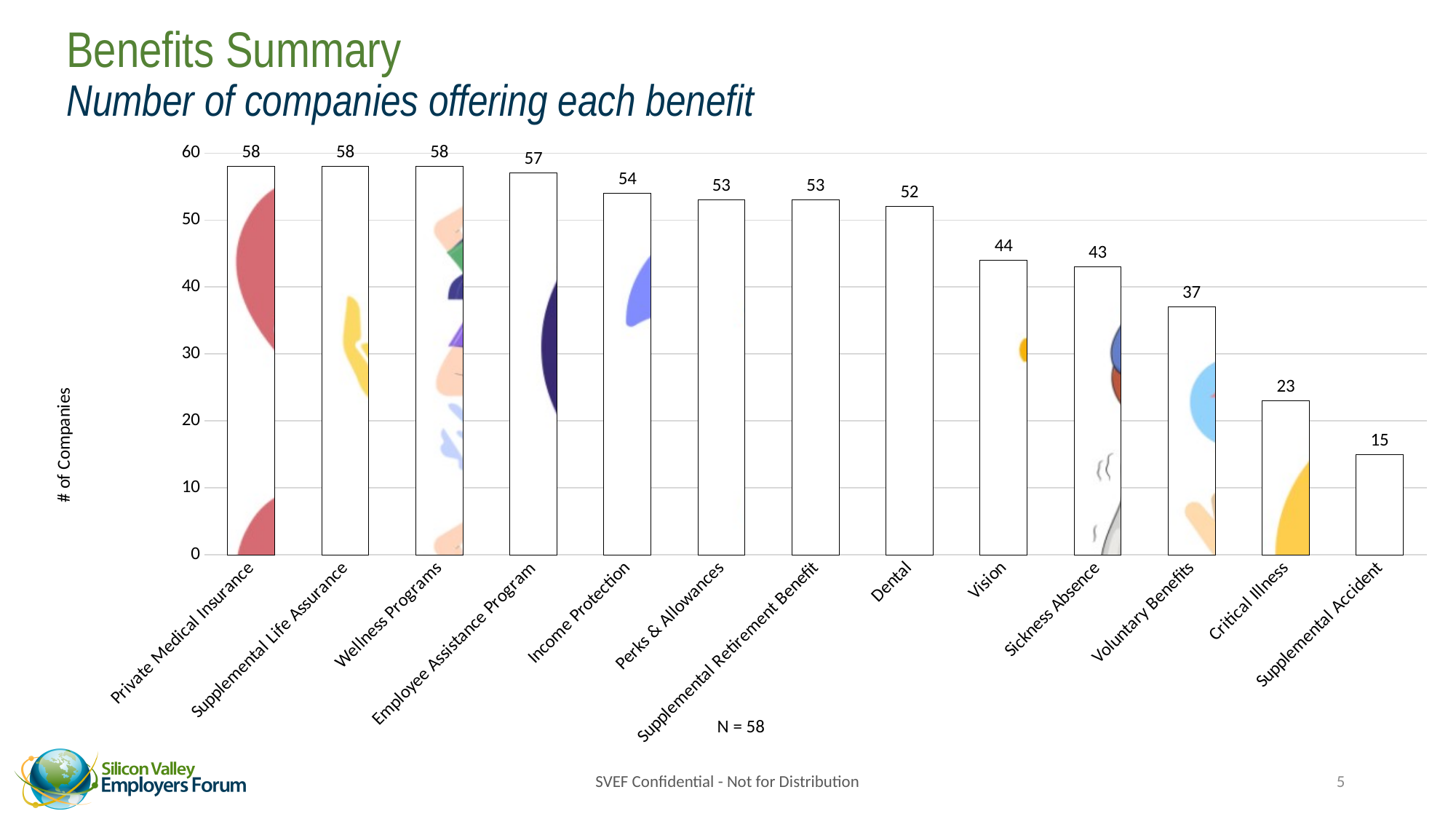
How many companies offer Dental? 52 What is the difference between the values for Private Medical Insurance and Supplemental Accident? 43 What is the label on the vertical axis? # of Companies How many companies offer Income Protection? 54 Which benefit is offered by the fewest companies? Supplemental Accident What is the value for Critical Illness? 23 Which is larger, the value for Voluntary Benefits or the value for Critical Illness? Voluntary Benefits What is the difference between the values for Vision and Sickness Absence? 1 What kind of chart is shown on the slide? bar chart Is the value for Vision greater or less than 40? greater How many benefit categories are shown on the chart? 13 Do the values rise or fall from left to right along the x axis? fall